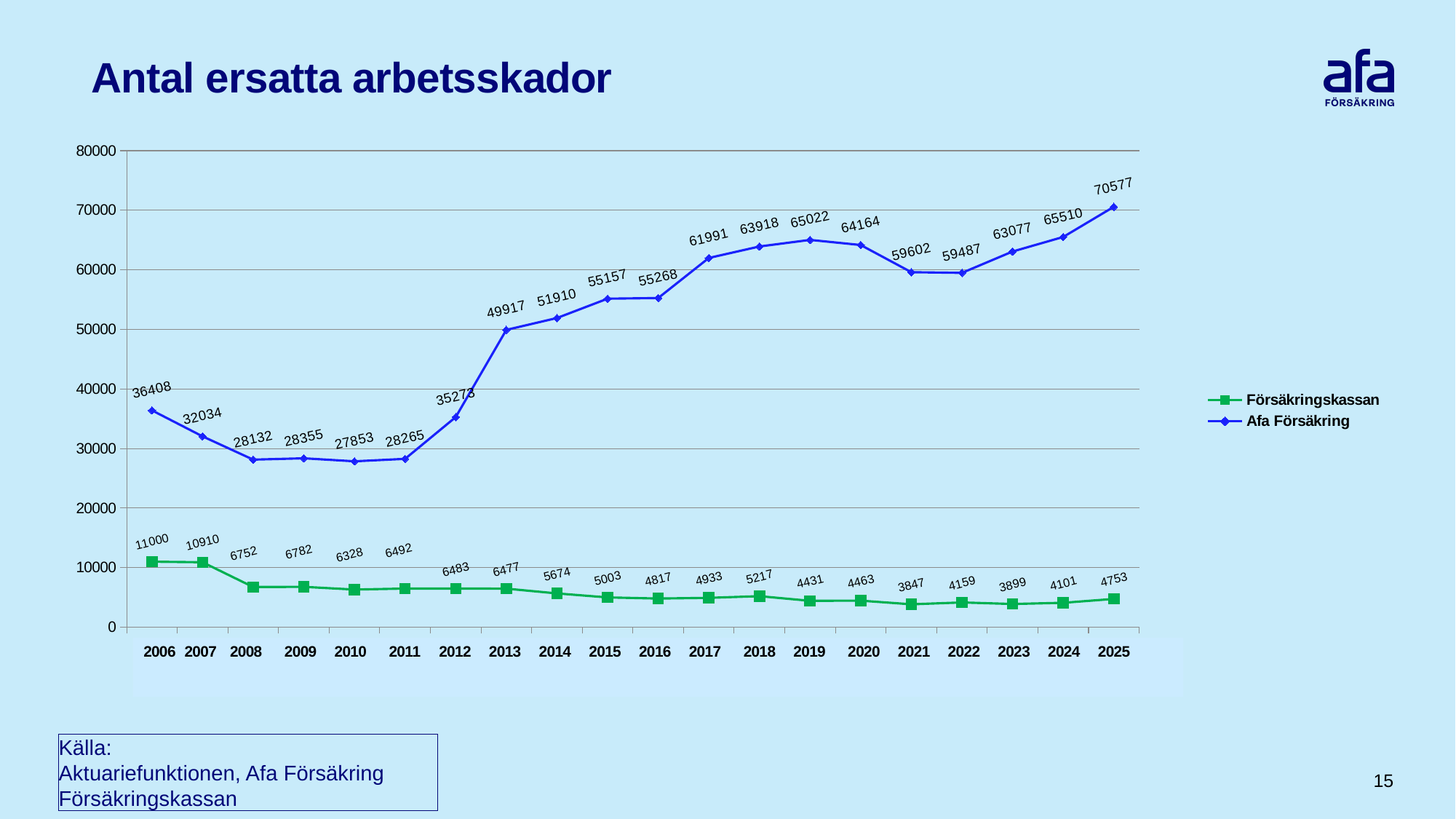
How many years are plotted along the x axis? 20 In which year is the Försäkringskassan value highest? 2006 In which year is the Afa Försäkring value highest? 2025 What is the difference between Afa Försäkring and Försäkringskassan in 2025? 65824 What is the value for Försäkringskassan in 2021? 3847 What is the title of the chart? Antal ersatta arbetsskador Which series has the larger value in 2006, Afa Försäkring or Försäkringskassan? Afa Försäkring What type of chart is shown on the slide? Line chart In which year is the Afa Försäkring value lowest? 2010 What is the value for Afa Försäkring in 2025? 70577 What is the value for Afa Försäkring in 2013? 49917 How many series does the legend list? 2